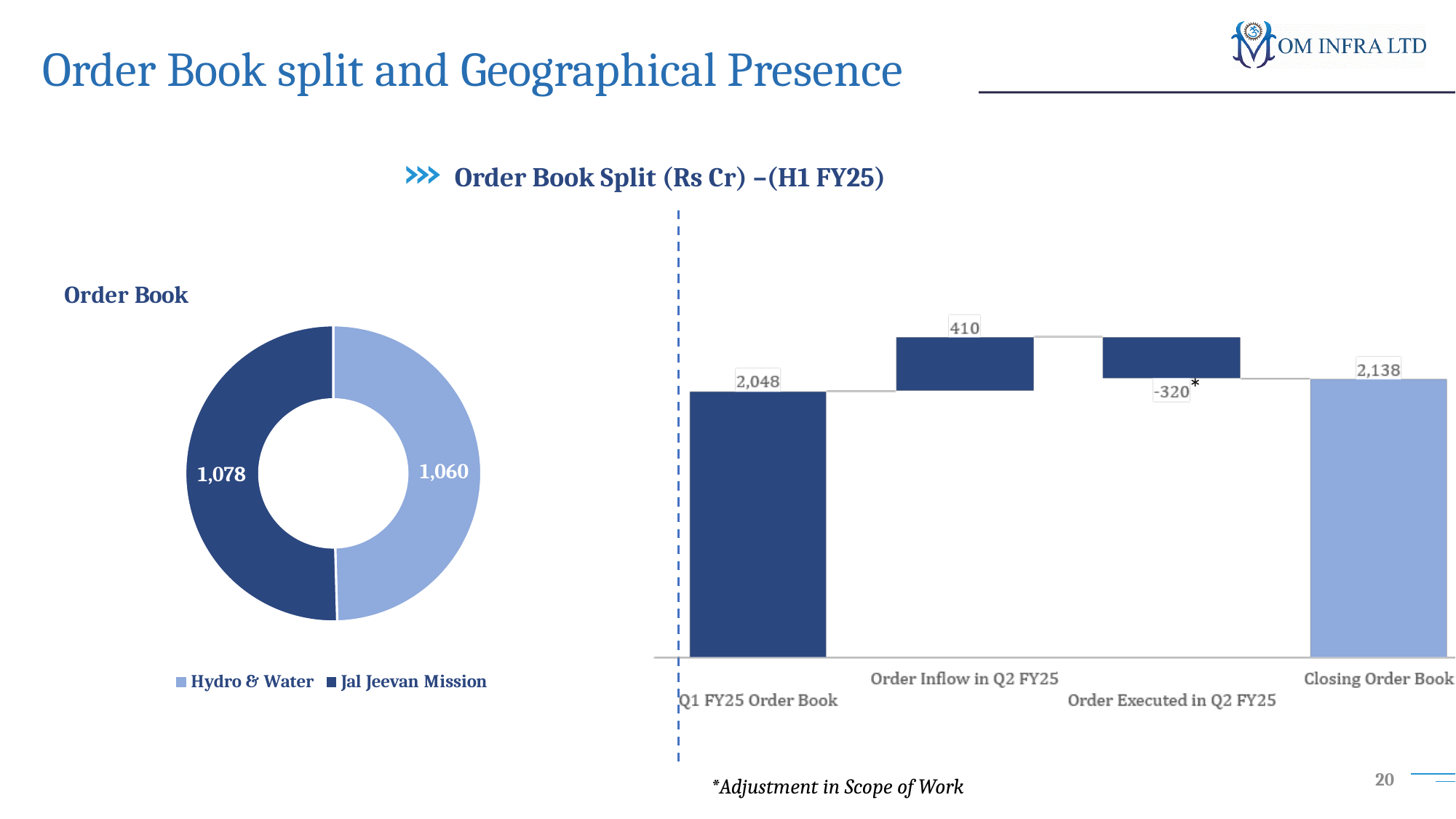
In the Order Book donut chart, what is the difference between the Jal Jeevan Mission and Hydro & Water values? 18 In the Order Book donut chart, what is the total of the two segments? 2,138 In the chart on the right, what is the value for Closing Order Book? 2,138 In the chart on the right, what is the value for Order Executed in Q2 FY25? -320 In the Order Book donut chart, what is the value for Jal Jeevan Mission? 1,078 In the Order Book donut chart, which segment has the larger value, Hydro & Water or Jal Jeevan Mission? Jal Jeevan Mission In the chart on the right, what is the value for Order Inflow in Q2 FY25? 410 In the chart on the right, what is the value for Q1 FY25 Order Book? 2,048 How many categories are shown on the x axis of the chart on the right? 4 How many entries does the legend of the Order Book donut chart list? 2 In the Order Book donut chart, what is the value for Hydro & Water? 1,060 In the chart on the right, what is the difference between the Closing Order Book and the Q1 FY25 Order Book? 90